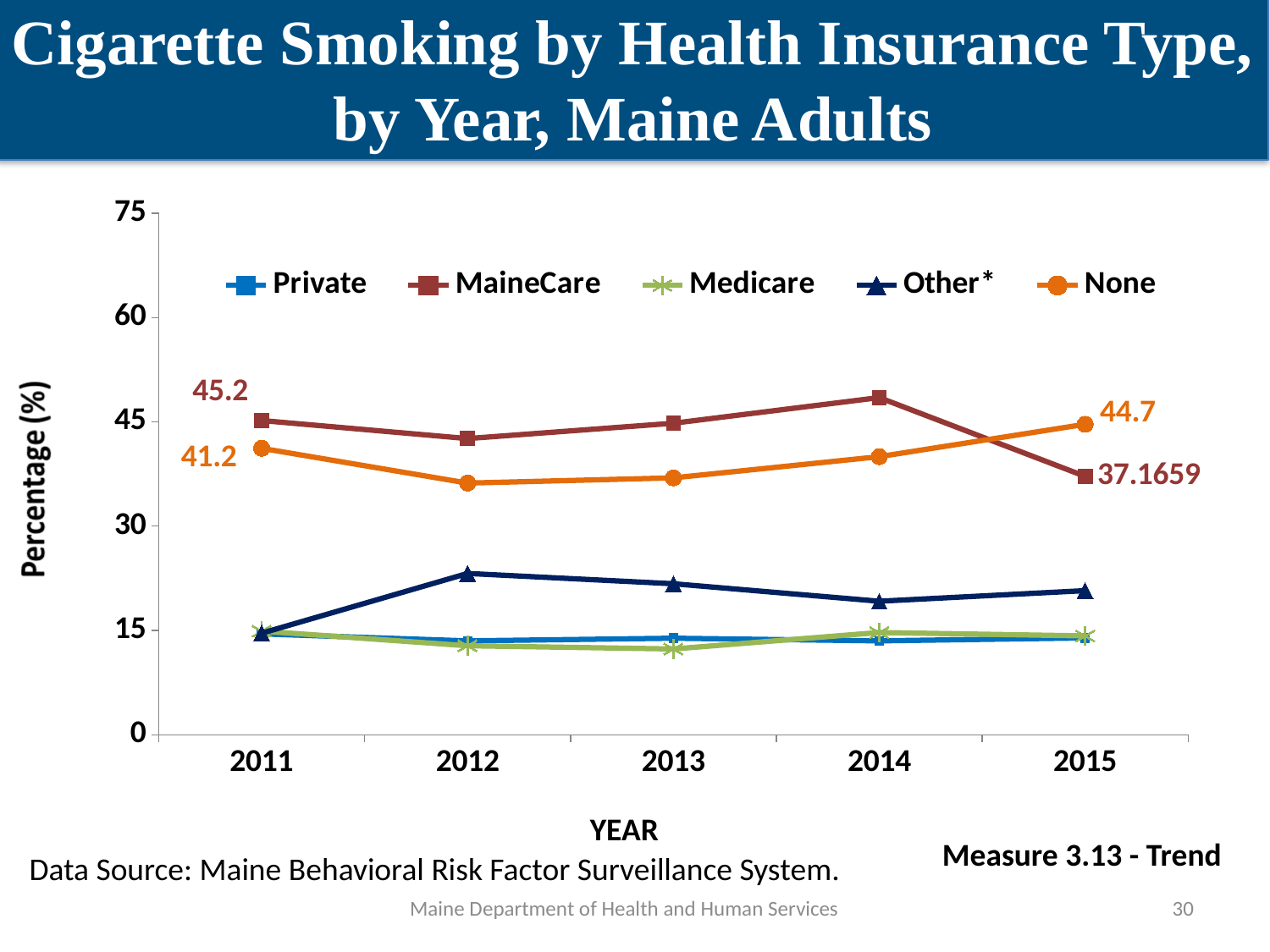
How many series does the legend list? 5 What is the MaineCare value in 2015? 37.1659 How many years are shown on the x axis? 5 What is the None value in 2011? 41.2 Does the MaineCare line rise or fall from 2014 to 2015? fall In 2015, which is larger: the None value or the MaineCare value? None Which series has the highest value in 2014? MaineCare What kind of chart is shown on the slide? line chart By how much did the None value increase from 2011 to 2015? 3.5 Is the Other* value in 2012 greater or less than 15? greater What is the MaineCare value in 2011? 45.2 What is the None value in 2015? 44.7